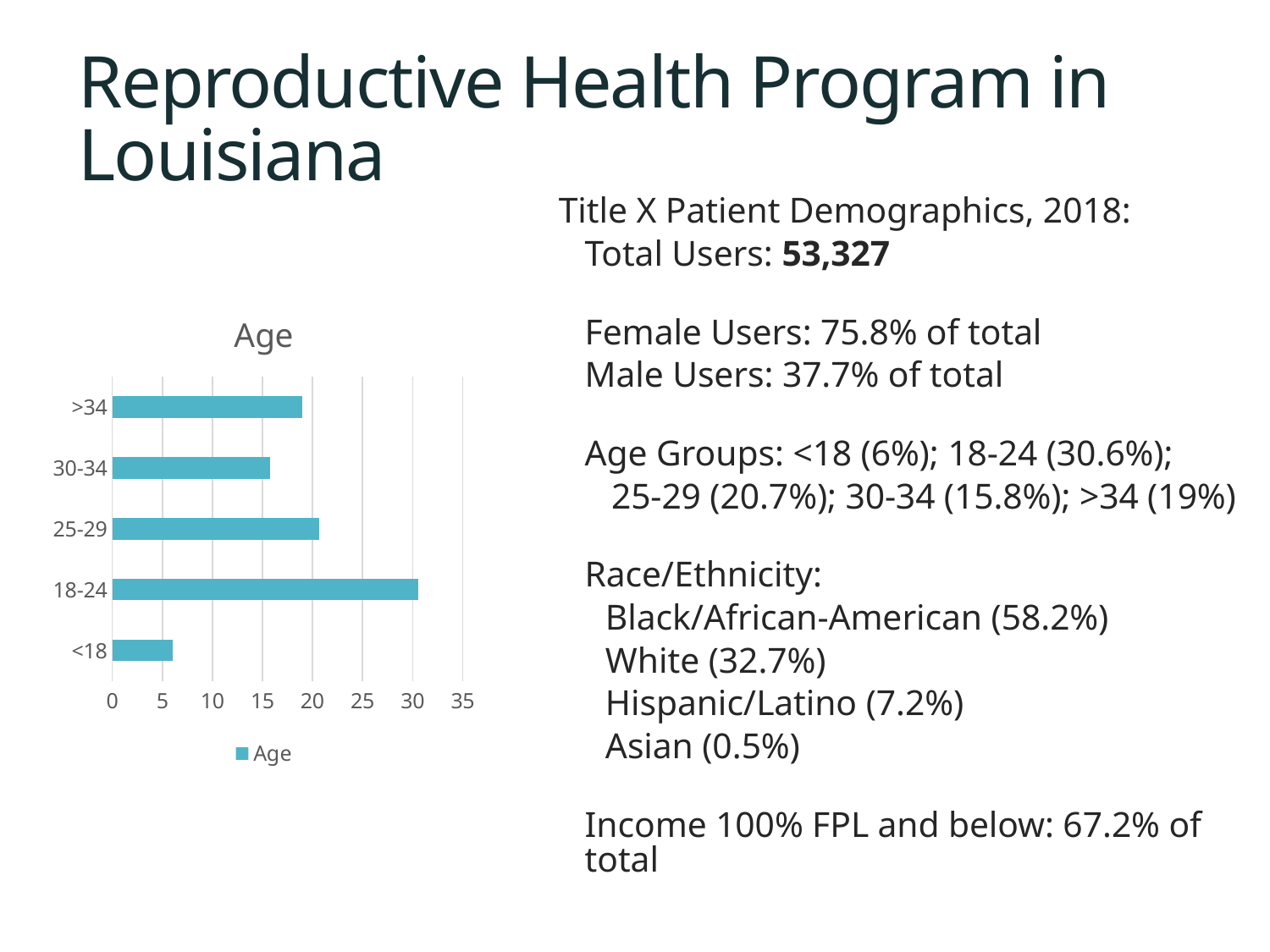
Which age group has the shortest bar in the chart? <18 How many age categories are plotted in the chart? 5 Which has the larger value, >34 or 30-34? >34 What is the title of the chart? Age What type of chart is shown on the slide? bar chart Is the value for >34 greater or less than 15? greater Is the value for 30-34 greater or less than 20? less Which age group has the longest bar in the chart? 18-24 Is the value for 18-24 greater or less than 25? greater Which has the larger value, 25-29 or 30-34? 25-29 How many series does the chart legend list? 1